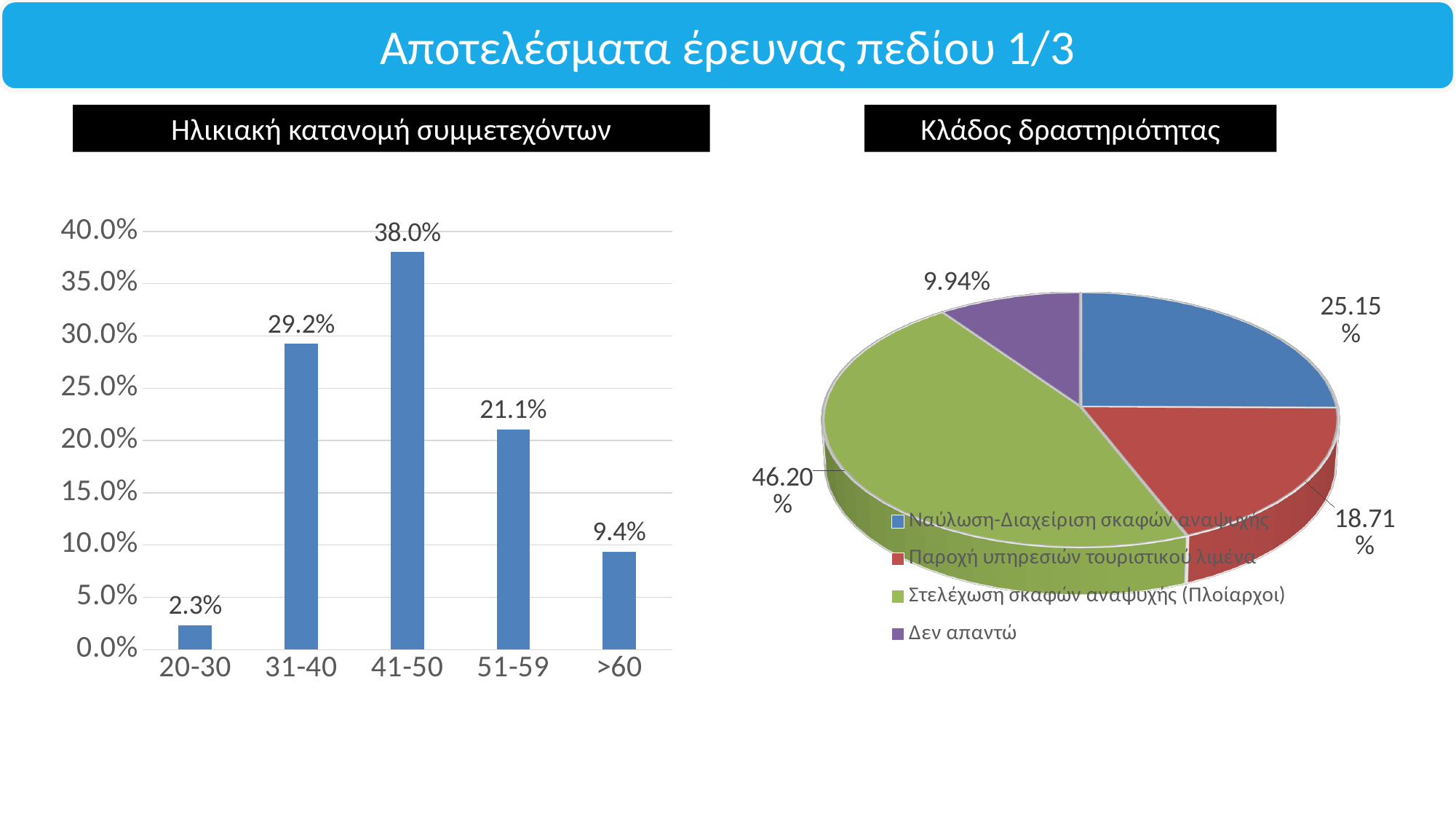
How many entries does the legend of the 'Κλάδος δραστηριότητας' chart list? 4 In the 'Ηλικιακή κατανομή συμμετεχόντων' chart, which age group has the highest value? 41-50 How many age groups are shown in the 'Ηλικιακή κατανομή συμμετεχόντων' chart? 5 In the 'Ηλικιακή κατανομή συμμετεχόντων' chart, what is the difference between the values for 31-40 and 51-59? 8.1% In the 'Ηλικιακή κατανομή συμμετεχόντων' chart, which is larger: the value for 31-40 or the value for 51-59? 31-40 In the 'Κλάδος δραστηριότητας' chart, what is the value for 'Δεν απαντώ'? 9.94% In the 'Κλάδος δραστηριότητας' chart, what share does 'Στελέχωση σκαφών αναψυχής (Πλοίαρχοι)' have? 46.20% In the 'Ηλικιακή κατανομή συμμετεχόντων' chart, what is the value for the 41-50 age group? 38.0% In the 'Κλάδος δραστηριότητας' chart, which category has the largest slice? Στελέχωση σκαφών αναψυχής (Πλοίαρχοι) What kind of chart is the 'Ηλικιακή κατανομή συμμετεχόντων' chart? Bar chart In the 'Ηλικιακή κατανομή συμμετεχόντων' chart, which age group has the lowest value? 20-30 In the 'Ηλικιακή κατανομή συμμετεχόντων' chart, what is the value for the >60 age group? 9.4%